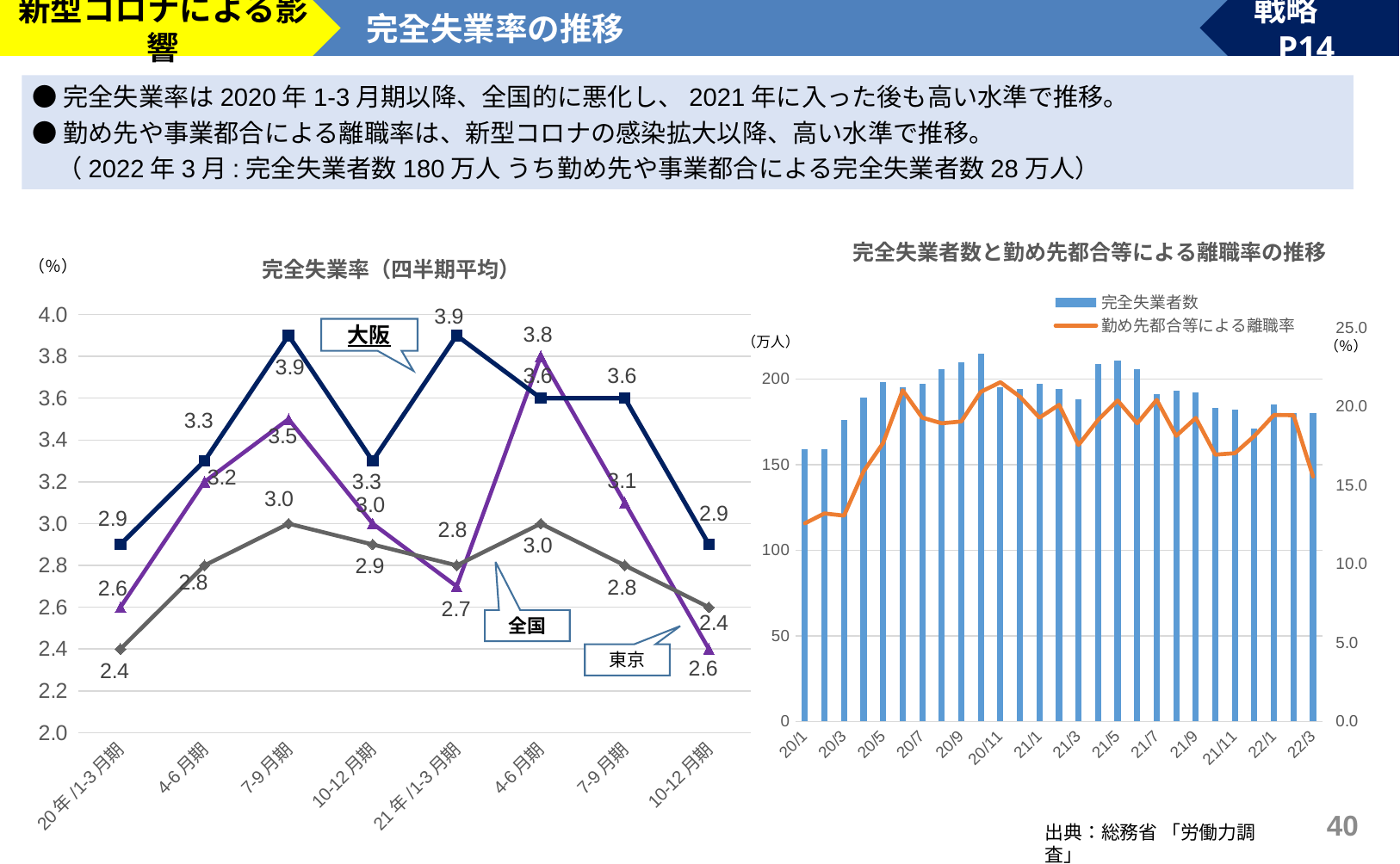
What kind of chart is the left chart titled 完全失業率（四半期平均）? Line chart In the left chart 完全失業率（四半期平均）, what is the value for 大阪 in 21年/1-3月期? 3.9 In the left chart 完全失業率（四半期平均）, how many quarterly periods are shown on the x axis? 8 In the left chart 完全失業率（四半期平均）, which is higher in 21年 4-6月期, 東京 or 大阪? 東京 In the left chart 完全失業率（四半期平均）, what is the value for 東京 in 21年 4-6月期? 3.8 In the left chart 完全失業率（四半期平均）, how many series (regions) are plotted? 3 In the left chart 完全失業率（四半期平均）, what is the value for 全国 in 20年/1-3月期? 2.4 In the left chart 完全失業率（四半期平均）, does the 全国 line rise or fall from 20年/1-3月期 to 20年 7-9月期? Rise In the right chart 完全失業者数と勤め先都合等による離職率の推移, is the 勤め先都合等による離職率 value for 22/3 greater or less than 20.0? less In the left chart 完全失業率（四半期平均）, what is the highest value reached by 大阪? 3.9 In the left chart 完全失業率（四半期平均）, what is the difference between 大阪 and 全国 in 20年 7-9月期? 0.9